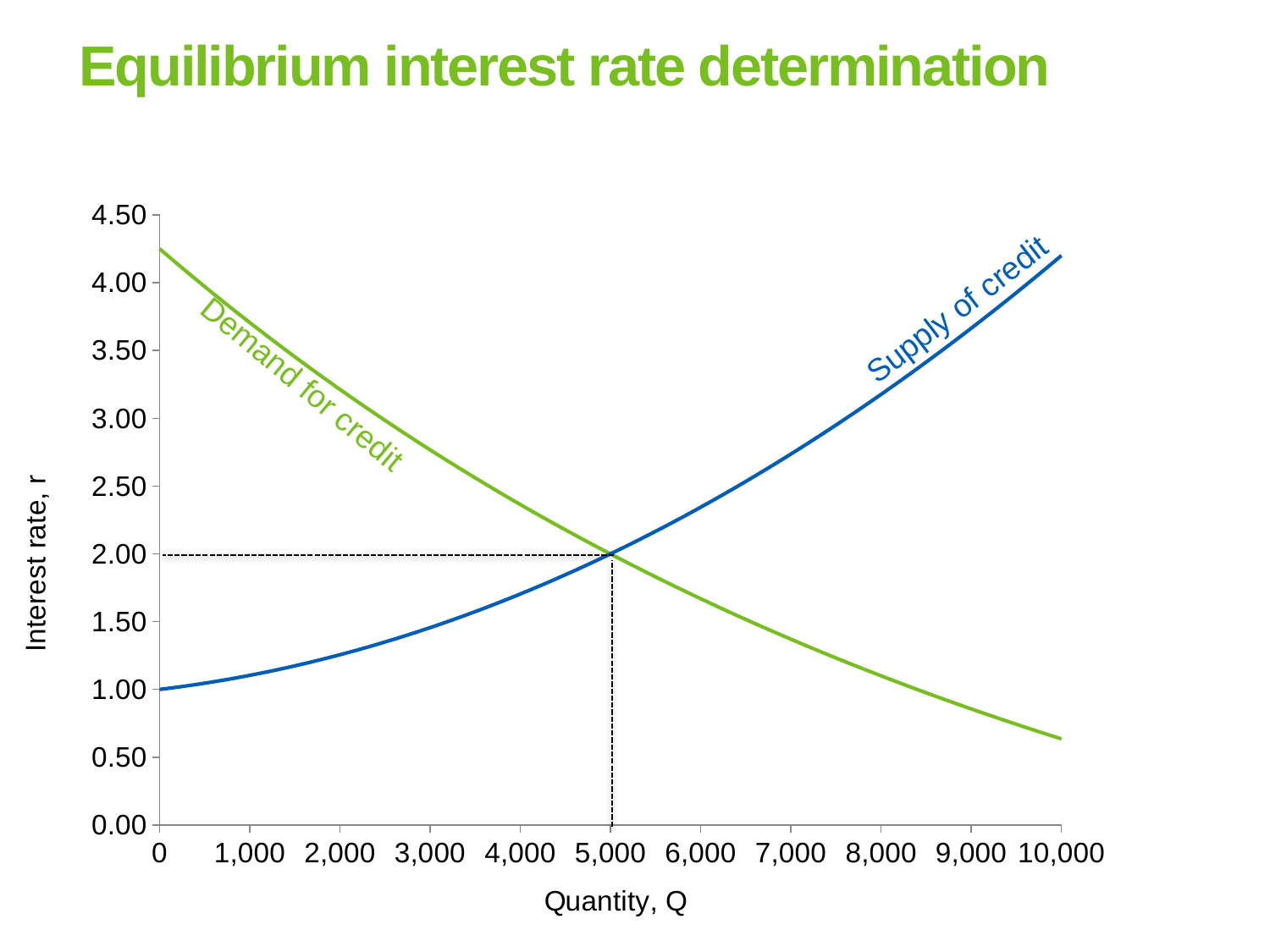
How many curves (series) are plotted on the chart? 2 What is the interest rate on the Supply of credit curve at a quantity of 0? 1.00 At a quantity of 2,000, which curve shows the higher interest rate, Demand for credit or Supply of credit? Demand for credit What is the label of the vertical axis of the chart? Interest rate, r At what interest rate do the Demand for credit and Supply of credit curves intersect, as marked by the dashed line? 2.00 Is the interest rate on the Demand for credit curve at a quantity of 10,000 greater or less than 1.00? less At what quantity do the Demand for credit and Supply of credit curves intersect, as marked by the dashed line? 5,000 At a quantity of 8,000, which curve shows the higher interest rate, Demand for credit or Supply of credit? Supply of credit What kind of chart is shown on the slide? line chart Does the Demand for credit curve rise or fall as quantity increases? fall Does the Supply of credit curve rise or fall as quantity increases? rise Is the interest rate on the Demand for credit curve at a quantity of 0 greater or less than 4.00? greater